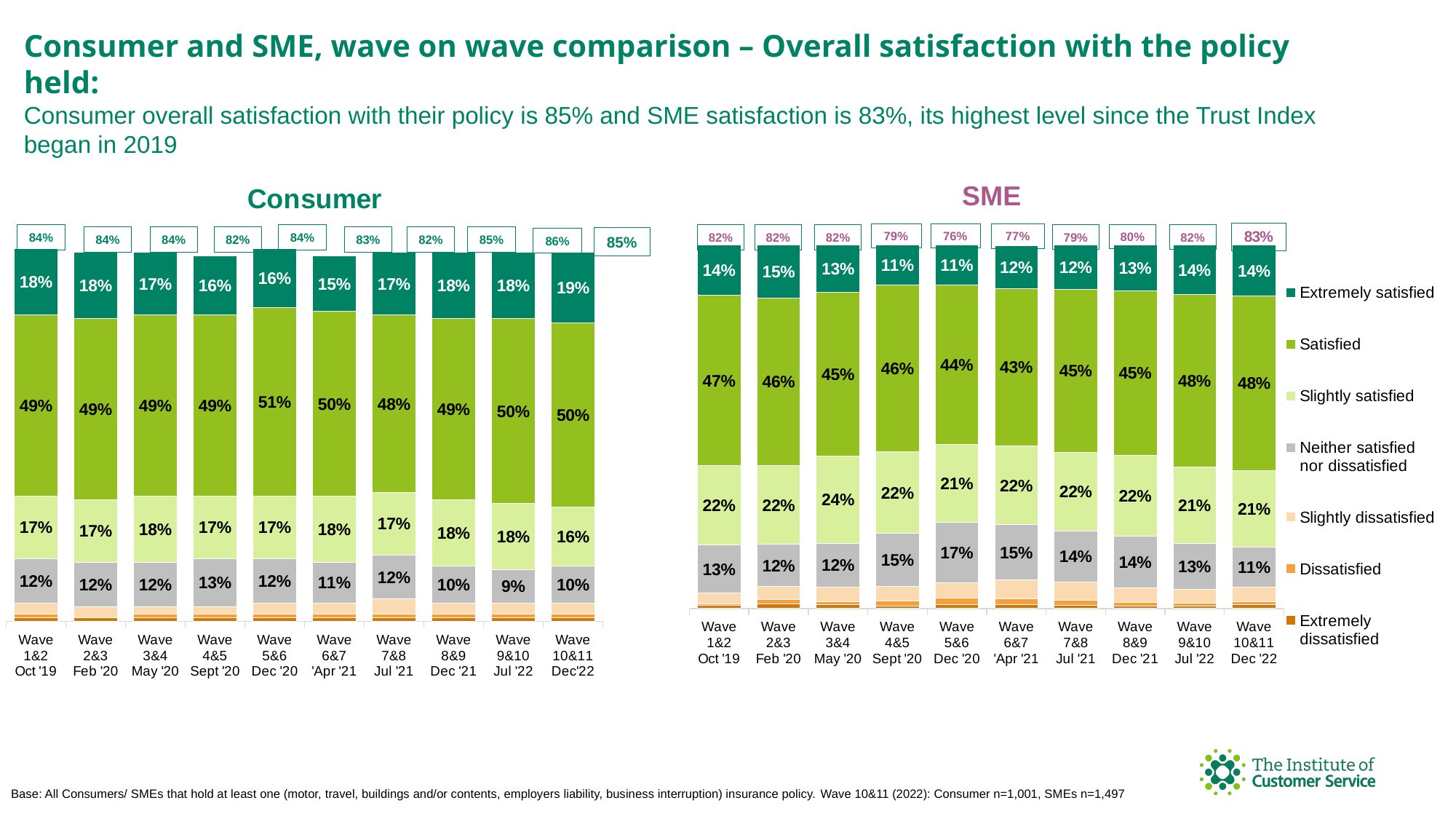
In the Consumer chart, what is the 'Satisfied' value for Wave 5&6 Dec '20? 51% In the SME chart, what is the combined 'Extremely satisfied' and 'Satisfied' value for Wave 1&2 Oct '19? 61% In the SME chart, what is the 'Neither satisfied nor dissatisfied' value for Wave 5&6 Dec '20? 17% Which legend entry is shown in dark green at the top of each bar? Extremely satisfied In the SME chart, which wave has the lowest 'Satisfied' value? Wave 6&7 'Apr '21 What type of chart is the Consumer chart? Stacked bar chart In the Consumer chart, which wave has the highest 'Extremely satisfied' value? Wave 10&11 Dec'22 In the Consumer chart, which is larger: the 'Neither satisfied nor dissatisfied' value for Wave 4&5 Sept '20 or for Wave 9&10 Jul '22? Wave 4&5 Sept '20 In the SME chart, what is the difference between the 'Satisfied' values for Wave 9&10 Jul '22 and Wave 6&7 'Apr '21? 5% In the SME chart, what is the 'Extremely satisfied' value for Wave 10&11 Dec '22? 14% How many series does the legend list for the SME chart? 7 How many waves are shown on the x axis of the SME chart? 10